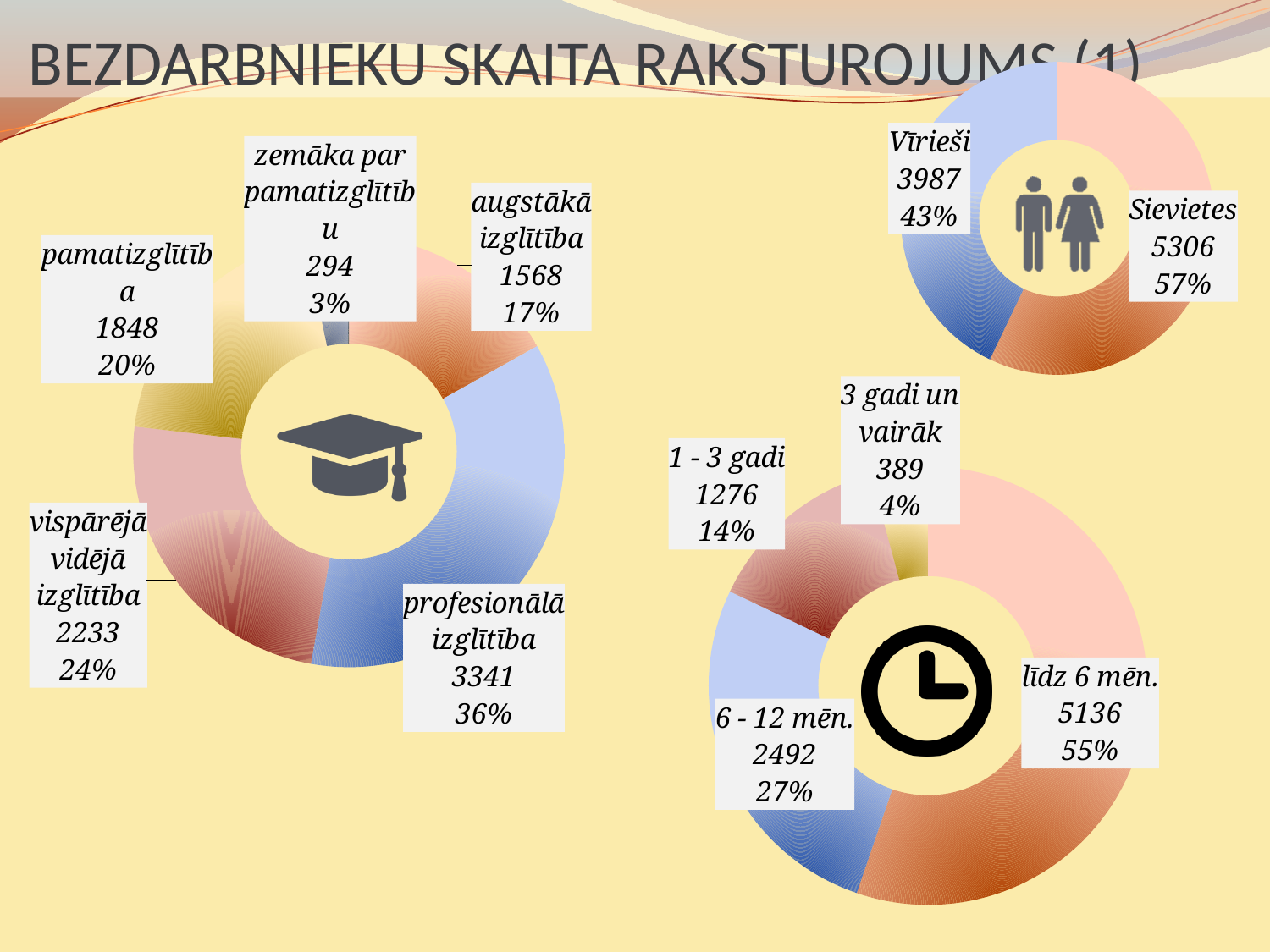
In the gender chart at the top right of the slide, what value is shown for Sievietes? 5306 In the gender chart at the top right of the slide, which is larger, Vīrieši or Sievietes? Sievietes In the duration chart at the bottom right of the slide, which category has the largest share? līdz 6 mēn. In the education chart on the left of the slide, what percentage is shown for vispārējā vidējā izglītība? 24% What kind of chart is the duration chart at the bottom right of the slide? doughnut chart In the duration chart at the bottom right of the slide (with the clock), what value is shown for 6 - 12 mēn.? 2492 In the education chart on the left of the slide, which category has the largest value? profesionālā izglītība In the education chart on the left of the slide, what is the difference between the values for vispārējā vidējā izglītība and pamatizglītība? 385 In the gender chart at the top right of the slide, what share of the total do Vīrieši represent? 43% In the education chart on the left of the slide (with the graduation cap), what value is shown for profesionālā izglītība? 3341